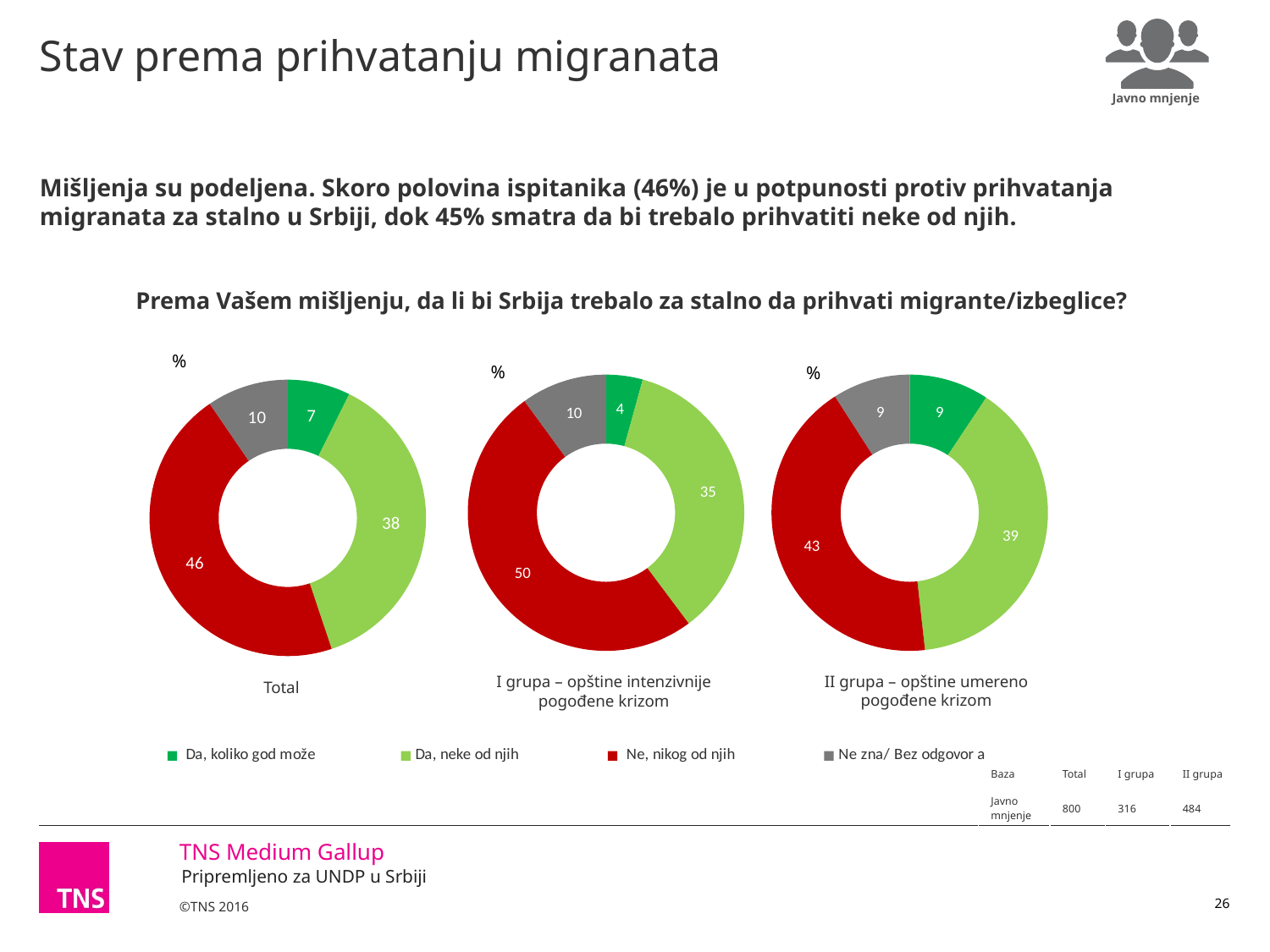
How many series does the legend list? 4 In the Total chart, which category has the largest share? Ne, nikog od njih Is the value for 'Ne, nikog od njih' in the 'I grupa' chart greater or less than the value for 'Ne, nikog od njih' in the 'II grupa' chart? greater In the 'I grupa – opštine intenzivnije pogođene krizom' chart, what is the value for 'Da, neke od njih'? 35 What colour represents 'Ne, nikog od njih' in the charts? Red In the 'II grupa' chart, what is the difference between 'Ne, nikog od njih' and 'Da, neke od njih'? 4 What kind of chart is used on this slide? Donut chart How many categories does each donut chart show? 4 In the 'I grupa' chart, which category has the smallest share? Da, koliko god može Which is larger in the 'I grupa' chart: 'Ne, nikog od njih' or 'Da, neke od njih'? Ne, nikog od njih In the Total chart, what is the value for 'Ne, nikog od njih'? 46 In the 'II grupa – opštine umereno pogođene krizom' chart, what is the value for 'Da, koliko god može'? 9